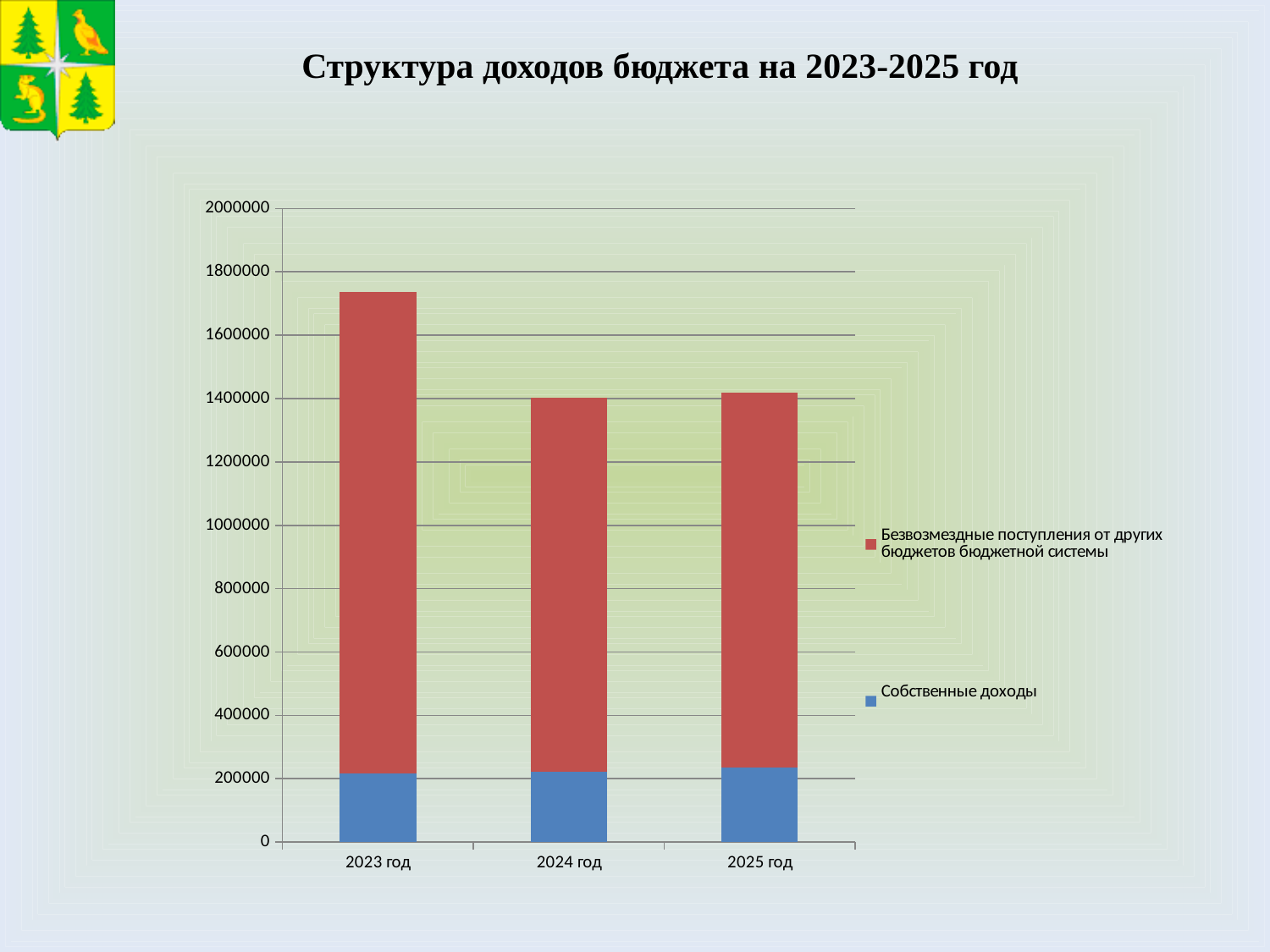
Which total bar is larger, 2023 год or 2024 год? 2023 год Is the total bar for 2025 год greater or less than 1200000? greater How many series does the chart legend list? 2 Which year has the highest total bar in the chart? 2023 год How many years (categories) are shown on the x axis of the chart? 3 Is the value of Собственные доходы for 2025 год greater or less than 400000? less Is the total bar for 2023 год greater or less than 1600000? greater What kind of chart is shown on the slide? Stacked bar chart Which year has the lowest total bar in the chart? 2024 год What is the title of the chart on the slide? Структура доходов бюджета на 2023-2025 год Which series is shown in blue in the chart? Собственные доходы